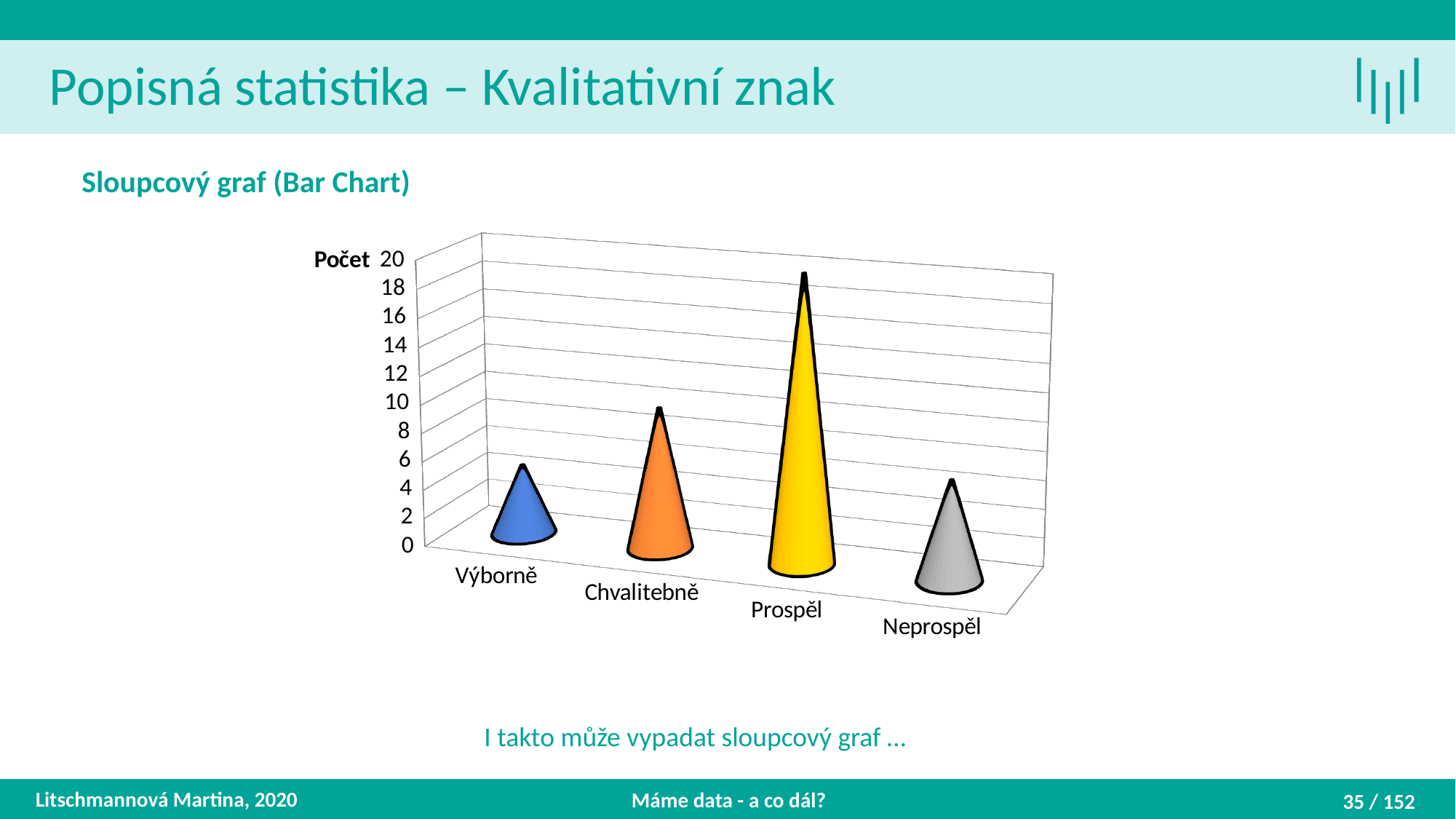
Is the value for Prospěl greater or less than 14? greater Which category has the highest value in the chart? Prospěl Which is larger, the value for Prospěl or the value for Neprospěl? Prospěl Is the value for Výborně greater or less than 10? less Is the value for Chvalitebně greater or less than 6? greater What colour is the bar for Prospěl? yellow How many categories are shown on the x axis of the chart? 4 What kind of chart is shown on the slide? bar chart What is the label of the vertical axis of the chart? Počet Which category has the lowest value in the chart? Výborně Which is larger, the value for Chvalitebně or the value for Výborně? Chvalitebně